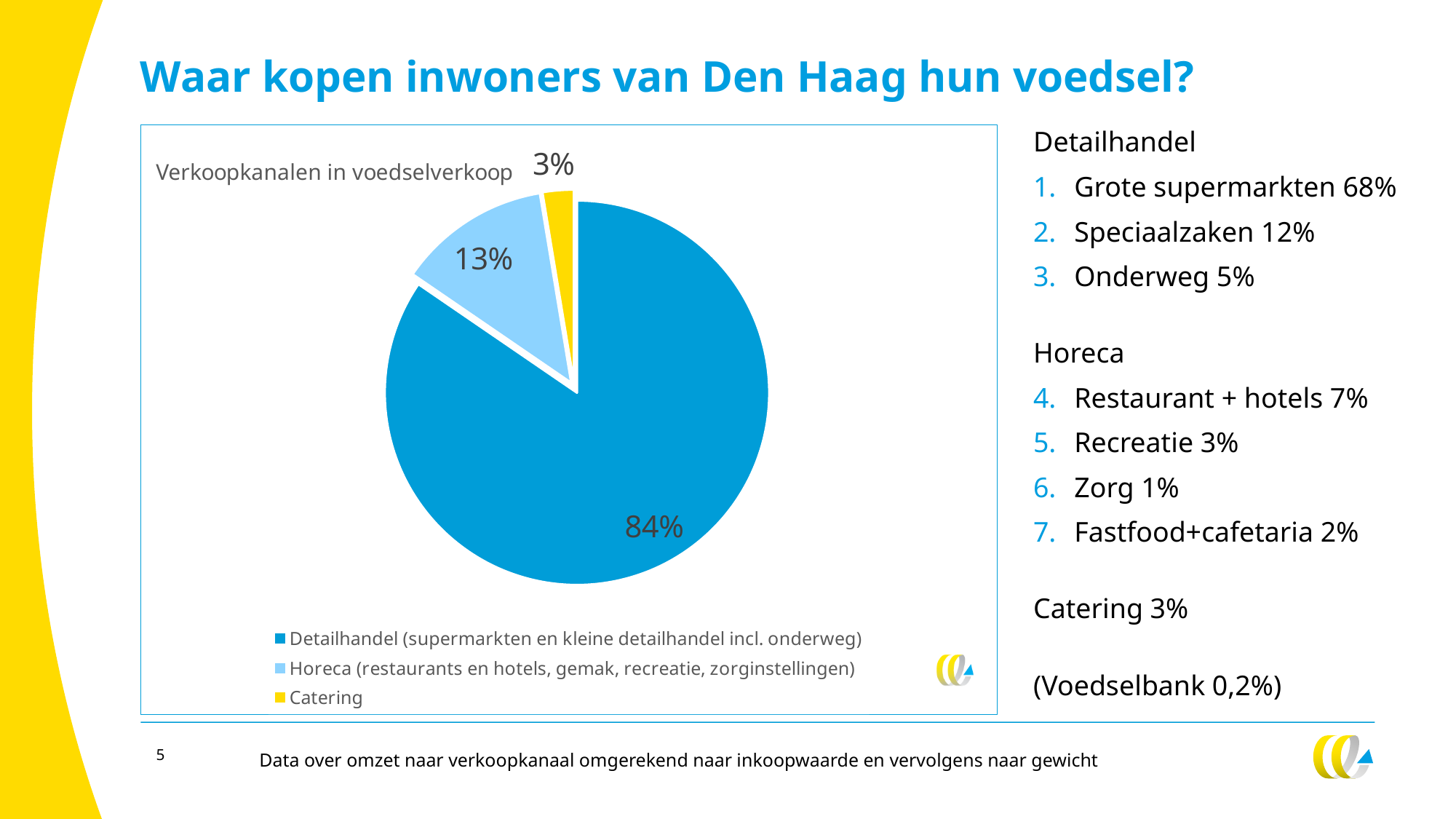
How many slices does the pie chart have? 3 Which category has the smallest slice of the pie? Catering How many entries does the legend list? 3 What share of the pie does Horeca (restaurants en hotels, gemak, recreatie, zorginstellingen) have? 13% What share of the pie does Detailhandel (supermarkten en kleine detailhandel incl. onderweg) have? 84% Which category has the largest slice of the pie? Detailhandel (supermarkten en kleine detailhandel incl. onderweg) What is the difference in percentage points between the Detailhandel slice and the Horeca slice? 71 What is the title of the chart? Verkoopkanalen in voedselverkoop What share of the pie does Catering have? 3% Which is larger, the Horeca slice or the Catering slice? Horeca What kind of chart is shown on the slide? pie chart What colour is the Catering slice? yellow